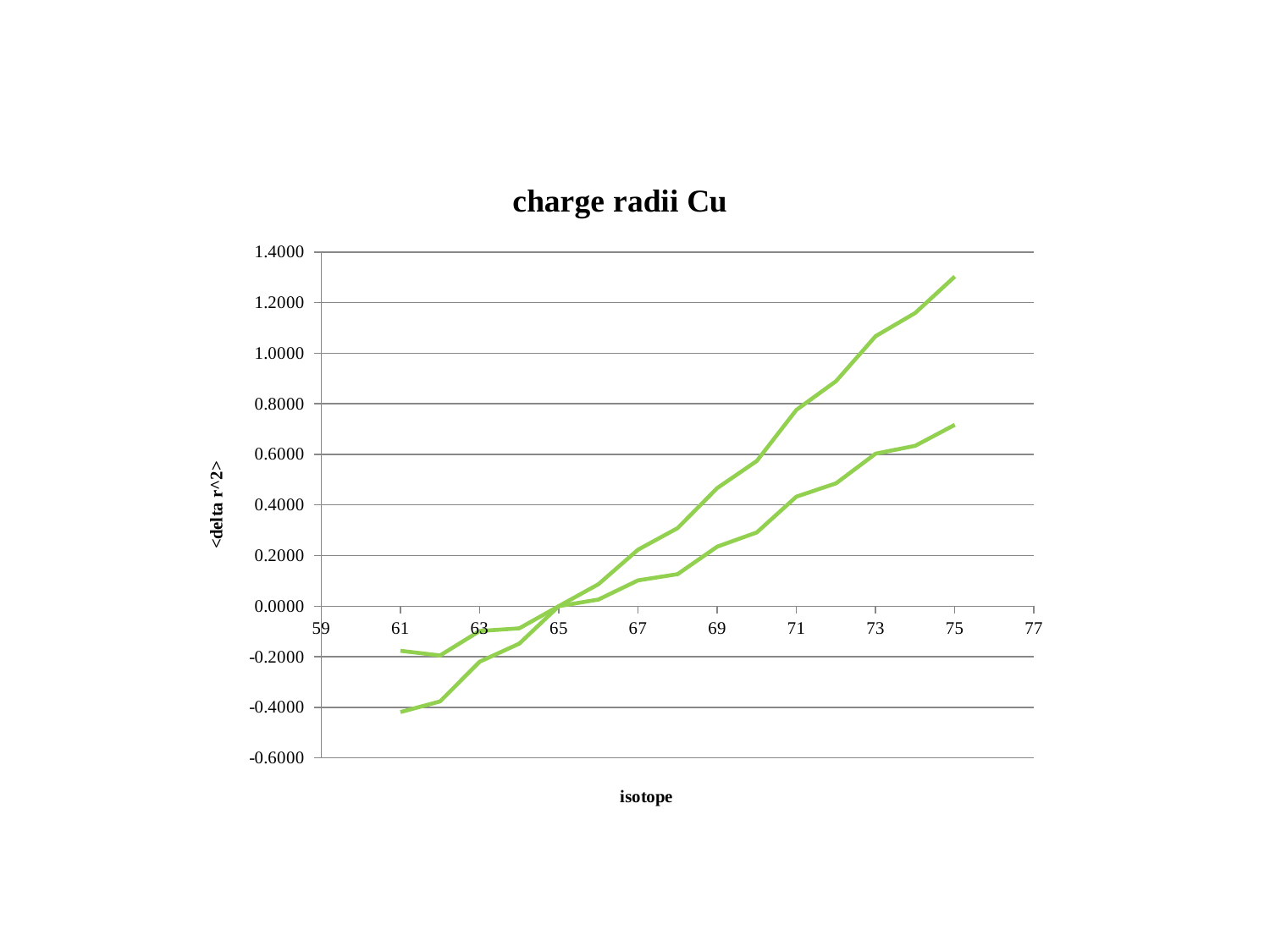
Is the value of the higher line at isotope 73 greater or less than 1.0000? greater Is the value of the higher line at isotope 69 greater or less than 0.4000? greater Is the value of the lower line at isotope 75 greater or less than 0.6000? greater What is the label on the x axis of the chart? isotope At which isotope do the two lines cross? 65 What kind of chart is shown on the slide? line chart Do the plotted values rise or fall as the isotope number increases along the x axis? rise What is the title of the chart? charge radii Cu How many lines are plotted on the chart? 2